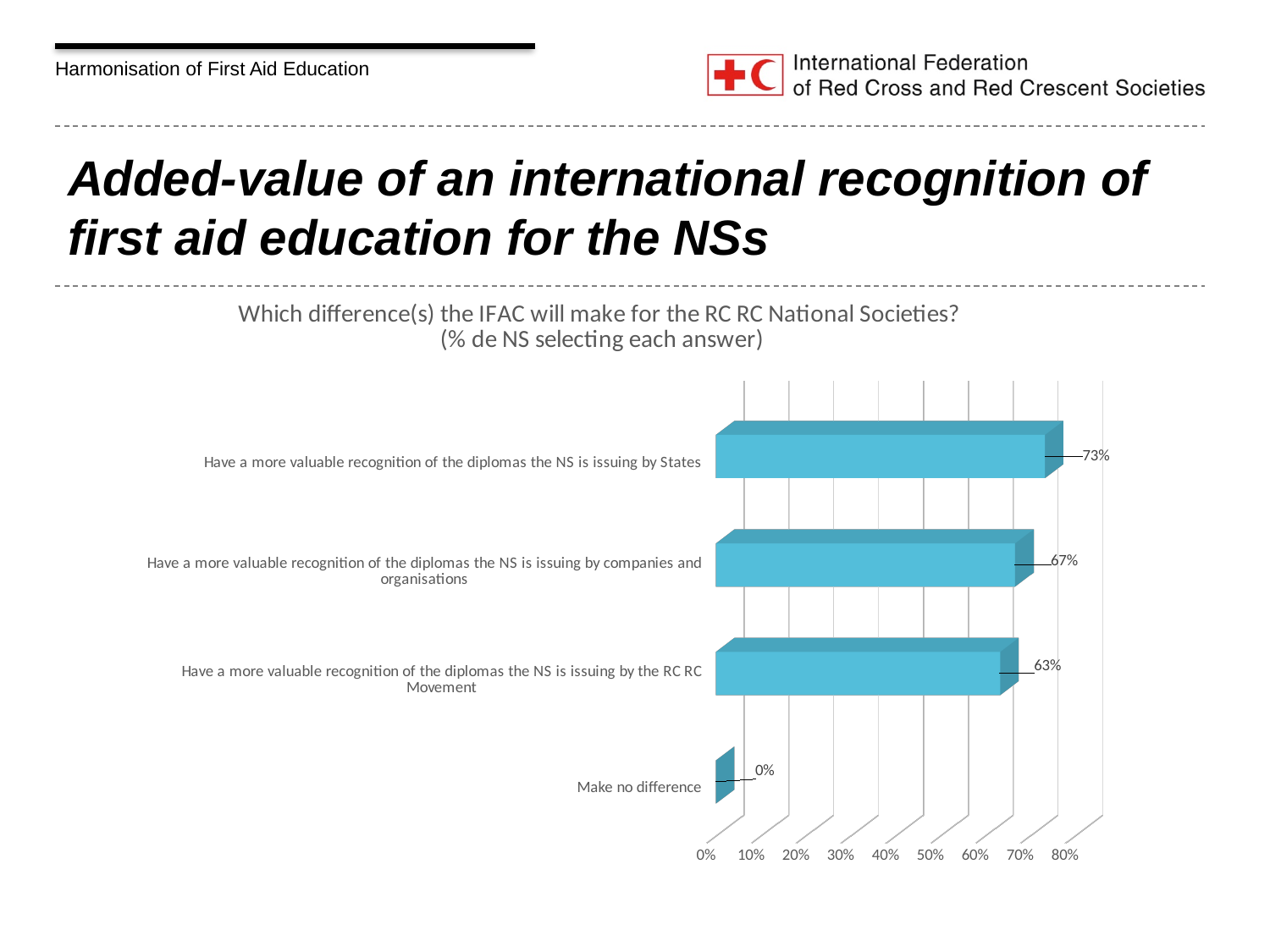
What kind of chart is shown on the slide? Bar chart Which answer was selected by the highest percentage of NSs? Have a more valuable recognition of the diplomas the NS is issuing by States What is the difference in percentage points between recognition by States and recognition by the RC RC Movement? 10 Which was selected by more NSs: recognition by States or recognition by companies and organisations? Recognition by States What is the title of the chart? Which difference(s) the IFAC will make for the RC RC National Societies? (% de NS selecting each answer) What percentage of NSs selected "Make no difference"? 0% What percentage of NSs selected "Have a more valuable recognition of the diplomas the NS is issuing by the RC RC Movement"? 63% How many answer categories are shown in the chart? 4 Which answer was selected by the lowest percentage of NSs? Make no difference What is the difference in percentage points between recognition by companies and organisations and recognition by the RC RC Movement? 4 What percentage of NSs selected "Have a more valuable recognition of the diplomas the NS is issuing by companies and organisations"? 67% What percentage of NSs selected "Have a more valuable recognition of the diplomas the NS is issuing by States"? 73%